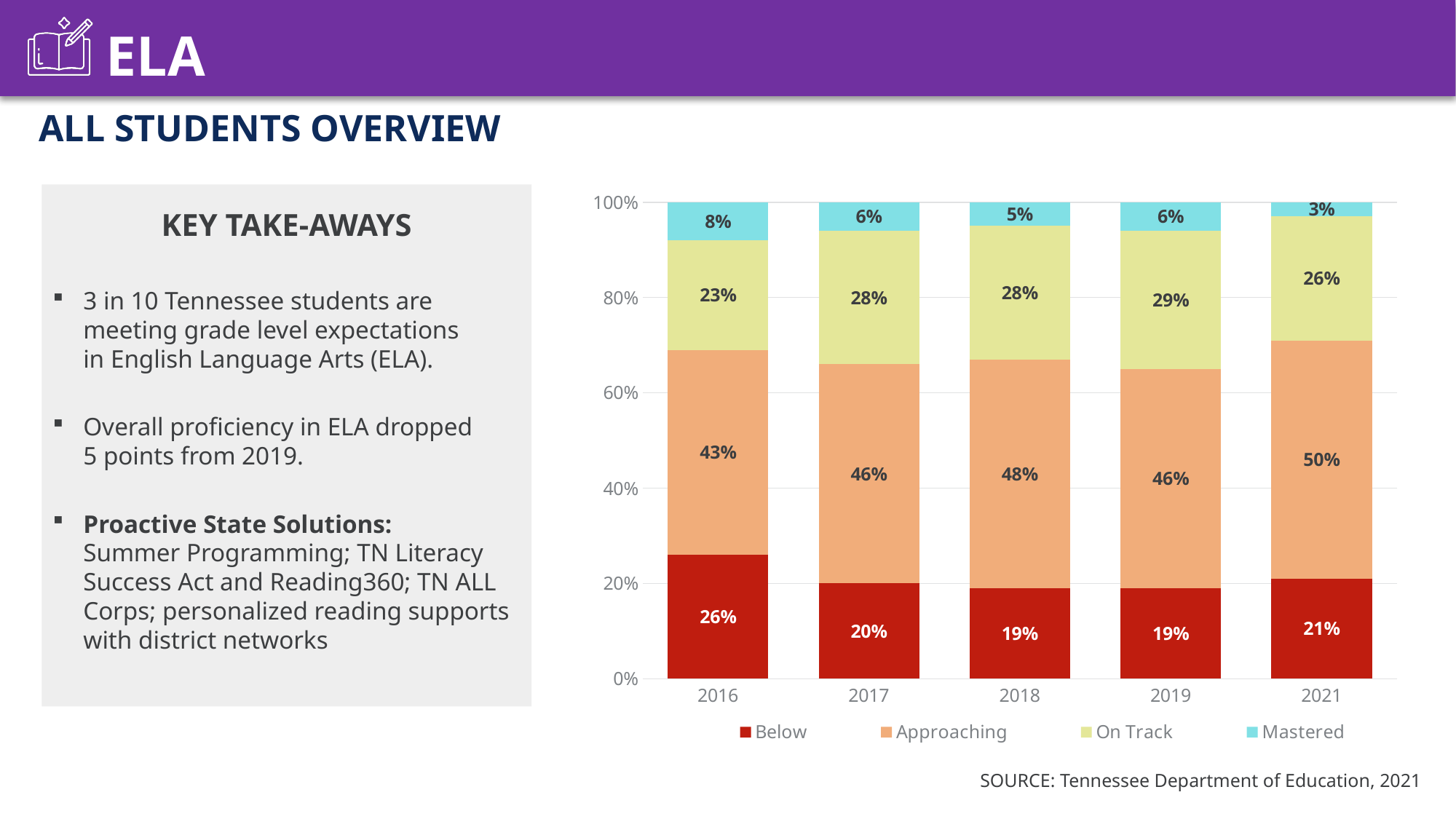
How many percentage points higher was the Approaching share in 2021 than in 2019? 4 What percentage of students Mastered in 2018? 5% What percentage of students were Approaching in 2021? 50% What percentage of students were On Track in 2019? 29% How many series does the legend list? 4 In which year was the Mastered share the lowest? 2021 What percentage of students were in the Below category in 2016? 26% How many years are shown on the x axis? 5 In which year was the Mastered share the highest? 2016 Which legend entry is shown in red? Below What kind of chart is shown on the slide? Stacked bar chart Which year had a larger Below share, 2016 or 2017? 2016